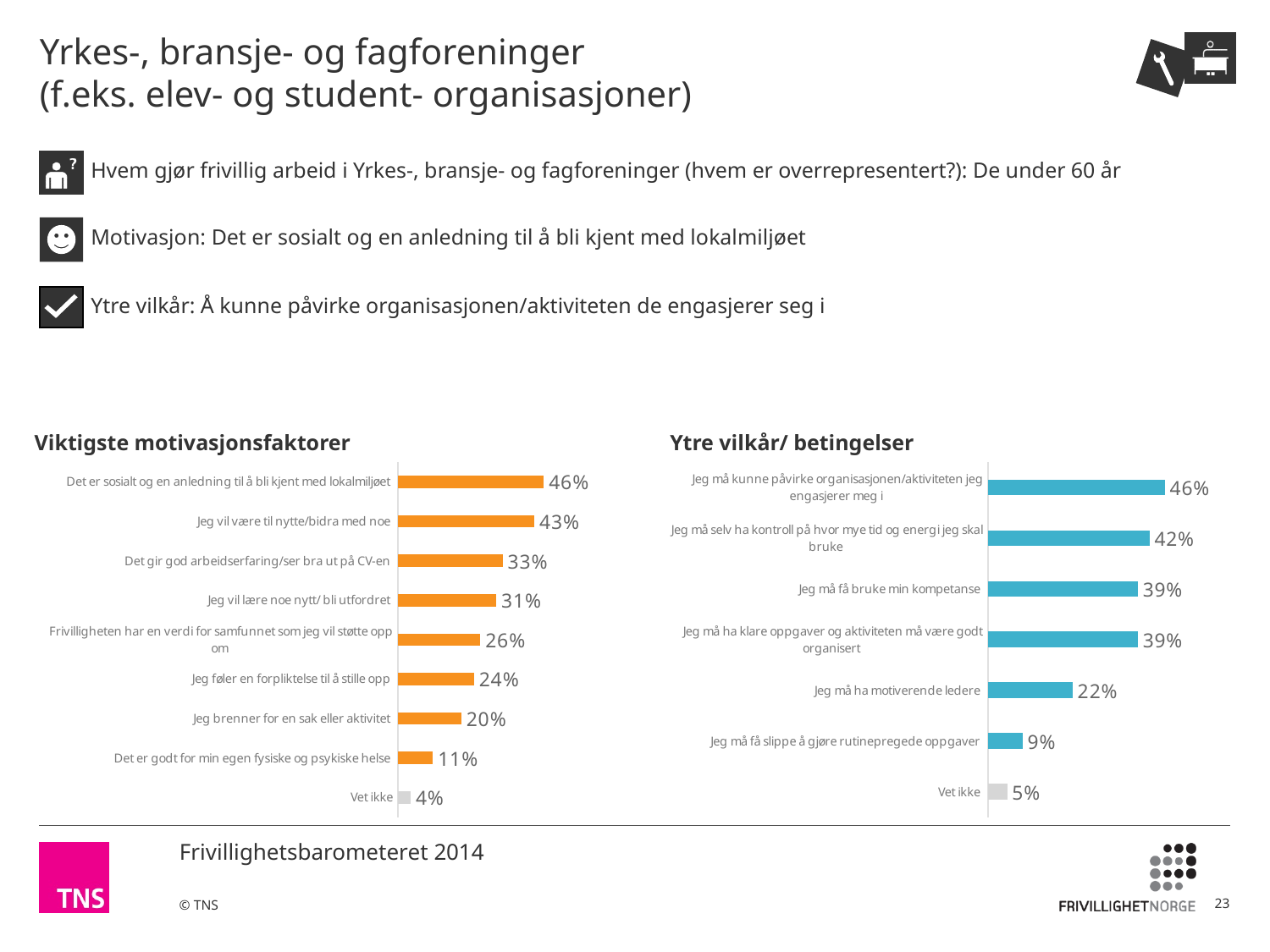
In the 'Viktigste motivasjonsfaktorer' chart, which category has the highest value? Det er sosialt og en anledning til å bli kjent med lokalmiljøet How many categories are shown in the 'Viktigste motivasjonsfaktorer' chart? 9 How many categories are shown in the 'Ytre vilkår/ betingelser' chart? 7 In the 'Ytre vilkår/ betingelser' chart, which category has the lowest value? Vet ikke In the 'Viktigste motivasjonsfaktorer' chart, what is the difference between 'Jeg vil være til nytte/bidra med noe' and 'Jeg brenner for en sak eller aktivitet'? 23% In the 'Viktigste motivasjonsfaktorer' chart, what is the value for 'Det gir god arbeidserfaring/ser bra ut på CV-en'? 33% What type of chart is the 'Ytre vilkår/ betingelser' chart? Bar chart In the 'Viktigste motivasjonsfaktorer' chart, what is the value for 'Det er godt for min egen fysiske og psykiske helse'? 11% In the 'Ytre vilkår/ betingelser' chart, which is larger: 'Jeg må selv ha kontroll på hvor mye tid og energi jeg skal bruke' or 'Jeg må ha motiverende ledere'? Jeg må selv ha kontroll på hvor mye tid og energi jeg skal bruke In the 'Ytre vilkår/ betingelser' chart, what is the value for 'Jeg må ha motiverende ledere'? 22% In the 'Viktigste motivasjonsfaktorer' chart, which is larger: 'Jeg vil lære noe nytt/ bli utfordret' or 'Jeg føler en forpliktelse til å stille opp'? Jeg vil lære noe nytt/ bli utfordret In the 'Ytre vilkår/ betingelser' chart, what is the difference between 'Jeg må kunne påvirke organisasjonen/aktiviteten jeg engasjerer meg i' and 'Jeg må få slippe å gjøre rutinepregede oppgaver'? 37%